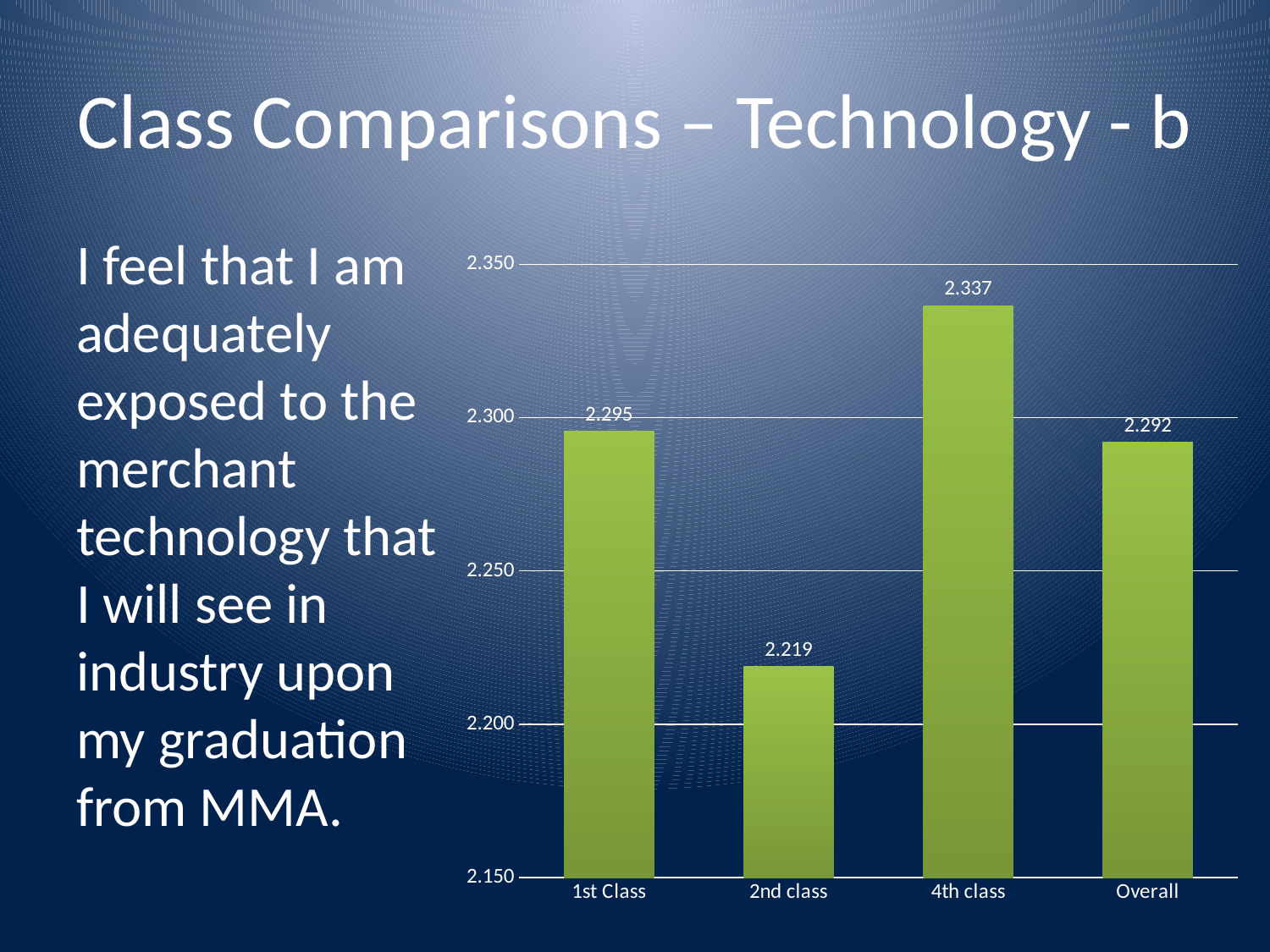
How many categories are shown on the x axis? 4 What is the value for Overall? 2.292 What is the value for 2nd class? 2.219 What kind of chart is shown on the slide? bar chart What is the difference between the values for 1st Class and Overall? 0.003 Which category has the highest value? 4th class Which category has the lowest value? 2nd class What is the difference between the values for 4th class and 2nd class? 0.118 Which is larger, the value for 1st Class or the value for 2nd class? 1st Class What is the value for 1st Class? 2.295 Is the value for 2nd class greater or less than 2.250? less What is the value for 4th class? 2.337